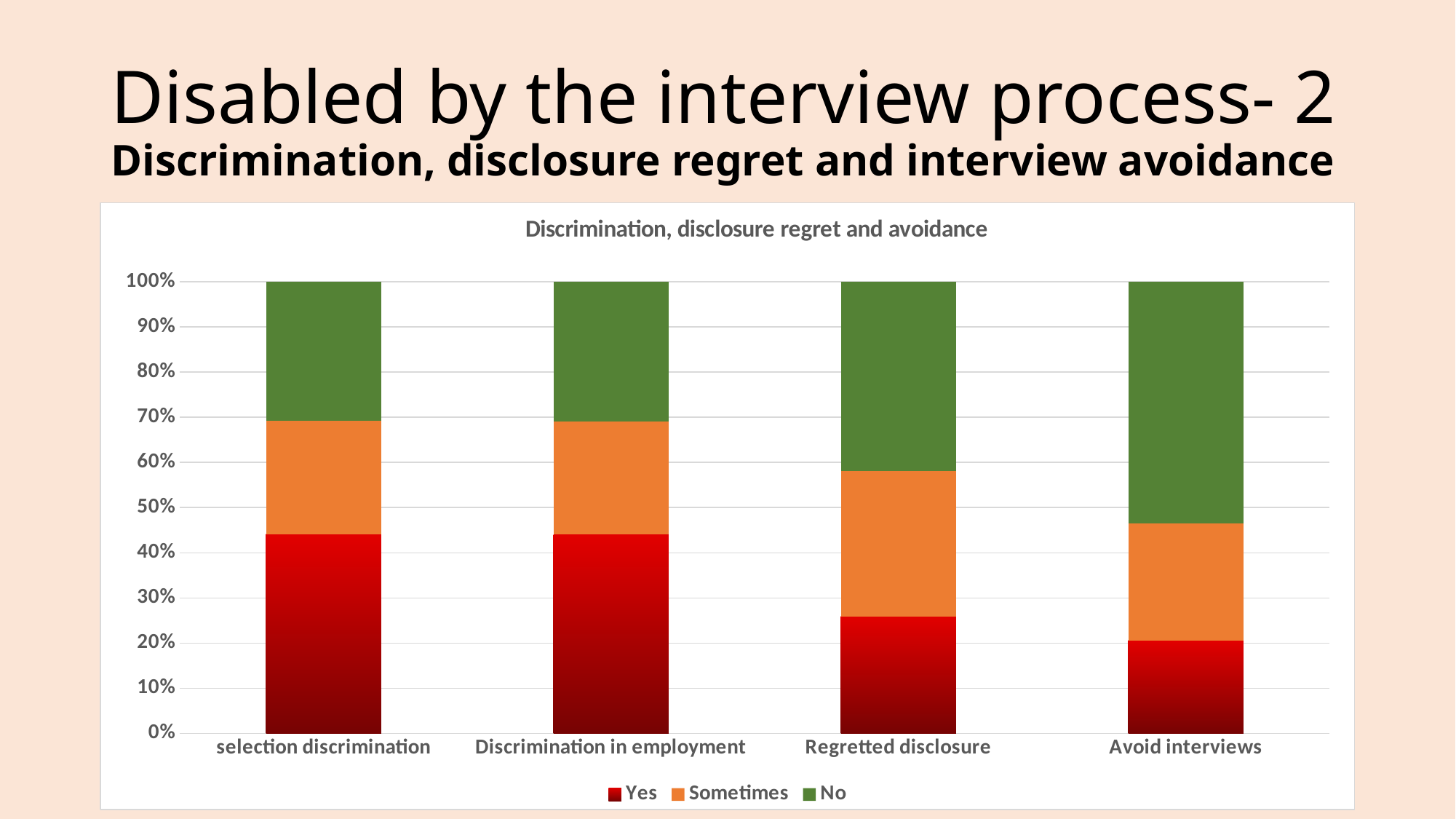
Is the 'Yes' value for Avoid interviews greater or less than 30%? less What is the total of the stacked bar for Avoid interviews? 100% What is the title of the chart? Discrimination, disclosure regret and avoidance What kind of chart is shown on the slide? Stacked bar chart How many series does the chart legend list? 3 How many categories are shown on the x axis of the chart? 4 Is the 'Yes' value for selection discrimination greater or less than 40%? greater Which has the larger 'Yes' segment: Regretted disclosure or Avoid interviews? Regretted disclosure Which series is shown in green in the chart? No Which category has the largest 'No' segment? Avoid interviews Which category has the smallest 'Yes' segment? Avoid interviews Is the 'Yes' value for Regretted disclosure greater or less than 30%? less